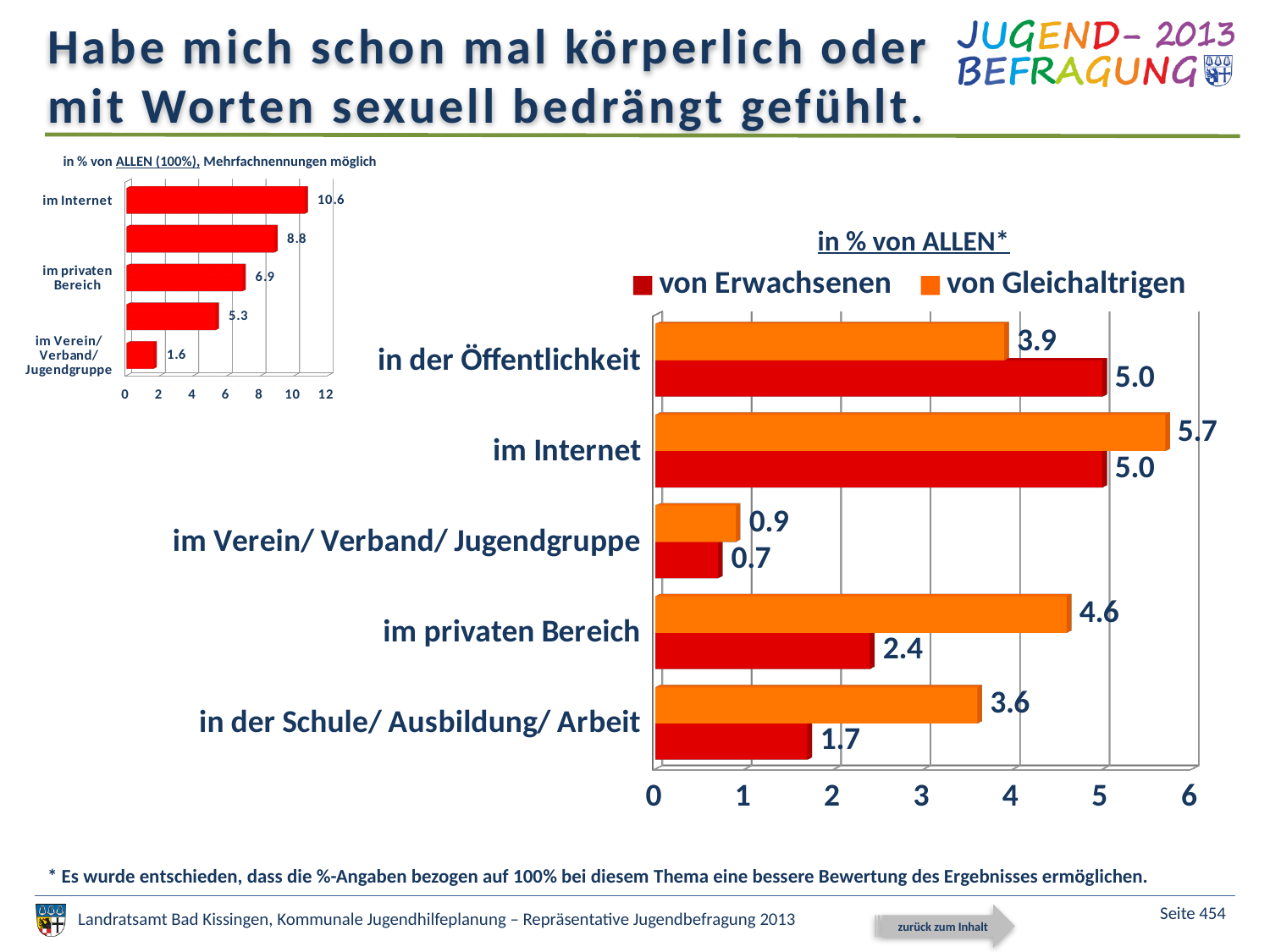
In the large chart on the right, which category has the lowest value for 'von Gleichaltrigen'? im Verein/ Verband/ Jugendgruppe In the small chart on the left, what is the value for 'im Internet'? 10.6 How many categories are shown in the large chart on the right? 5 In the large chart on the right, what is the difference between 'von Gleichaltrigen' and 'von Erwachsenen' in the category 'im privaten Bereich'? 2.2 How many series does the legend of the large chart on the right list? 2 In the large chart on the right, what is the value for 'von Gleichaltrigen' in the category 'im Internet'? 5.7 In the small chart on the left, what is the value for 'im Verein/ Verband/ Jugendgruppe'? 1.6 What kind of chart is the large chart on the right? bar chart In the large chart on the right, what is the value for 'von Erwachsenen' in the category 'in der Schule/ Ausbildung/ Arbeit'? 1.7 In the large chart on the right, which category has the highest value for 'von Gleichaltrigen'? im Internet In the large chart on the right, for 'in der Öffentlichkeit', which series has the larger value: 'von Erwachsenen' or 'von Gleichaltrigen'? von Erwachsenen In the large chart on the right, what is the value for 'von Erwachsenen' in the category 'im privaten Bereich'? 2.4